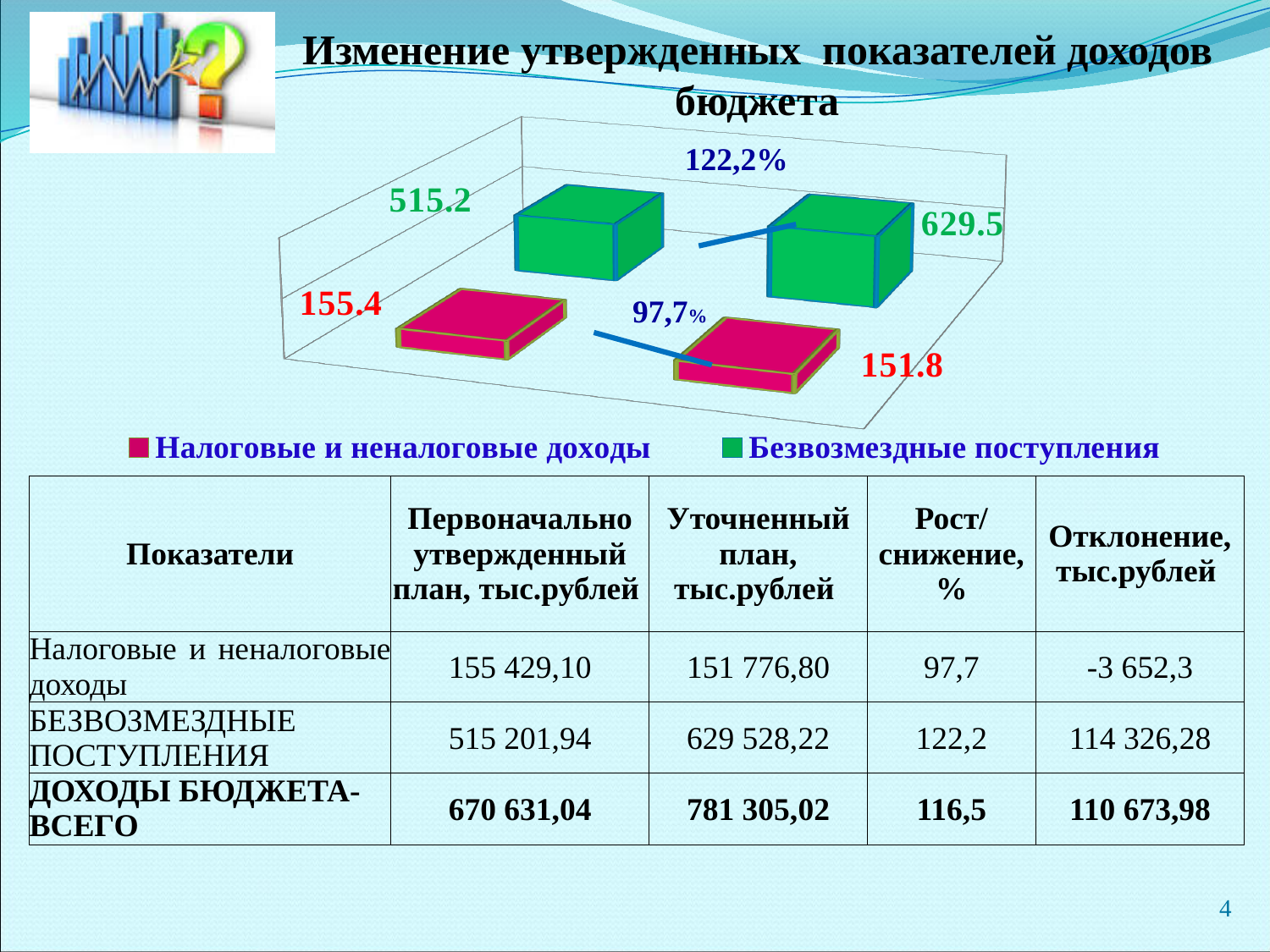
What is the value labelled on the left bar of the series 'Безвозмездные поступления'? 515.2 Which of the two 'Безвозмездные поступления' bars is larger, the left one or the right one? the right one (629.5) What is the value labelled on the right bar of the series 'Безвозмездные поступления'? 629.5 Do the values of the series 'Безвозмездные поступления' rise or fall from the left bar to the right bar? rise What is the value labelled on the right bar of the series 'Налоговые и неналоговые доходы'? 151.8 What percentage is annotated next to the 'Безвозмездные поступления' bars on the chart? 122,2% What is the difference between the two labelled values of the series 'Безвозмездные поступления'? 114.3 What is the value labelled on the left bar of the series 'Налоговые и неналоговые доходы'? 155.4 Do the values of the series 'Налоговые и неналоговые доходы' rise or fall from the left bar to the right bar? fall What kind of chart is shown on the slide? bar chart How many series does the chart legend list? 2 What is the difference between the two labelled values of the series 'Налоговые и неналоговые доходы'? 3.6